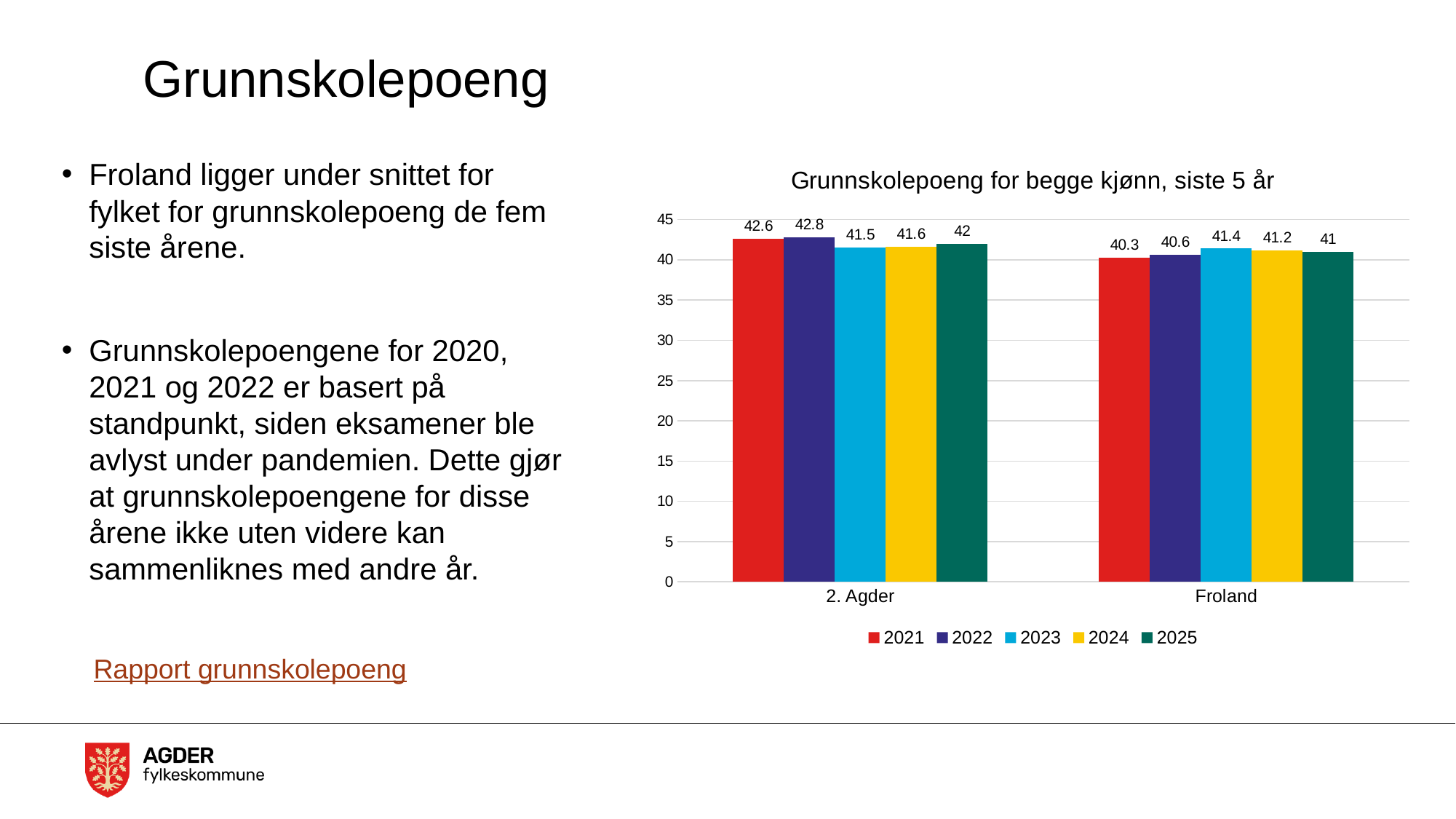
What is the title of the chart? Grunnskolepoeng for begge kjønn, siste 5 år What is the value for Froland in 2025? 41 How many categories are shown on the x axis? 2 What is the value for 2. Agder in 2021? 42.6 How many series does the legend list? 5 What is the difference between the 2. Agder and Froland values in 2021? 2.3 What kind of chart is shown? Bar chart Which year has the lowest value for Froland? 2021 Which year has the highest value for 2. Agder? 2022 What is the difference between the 2. Agder and Froland values in 2025? 1 What is the value for Froland in 2023? 41.4 Which is larger, the 2022 value for 2. Agder or the 2022 value for Froland? 2. Agder